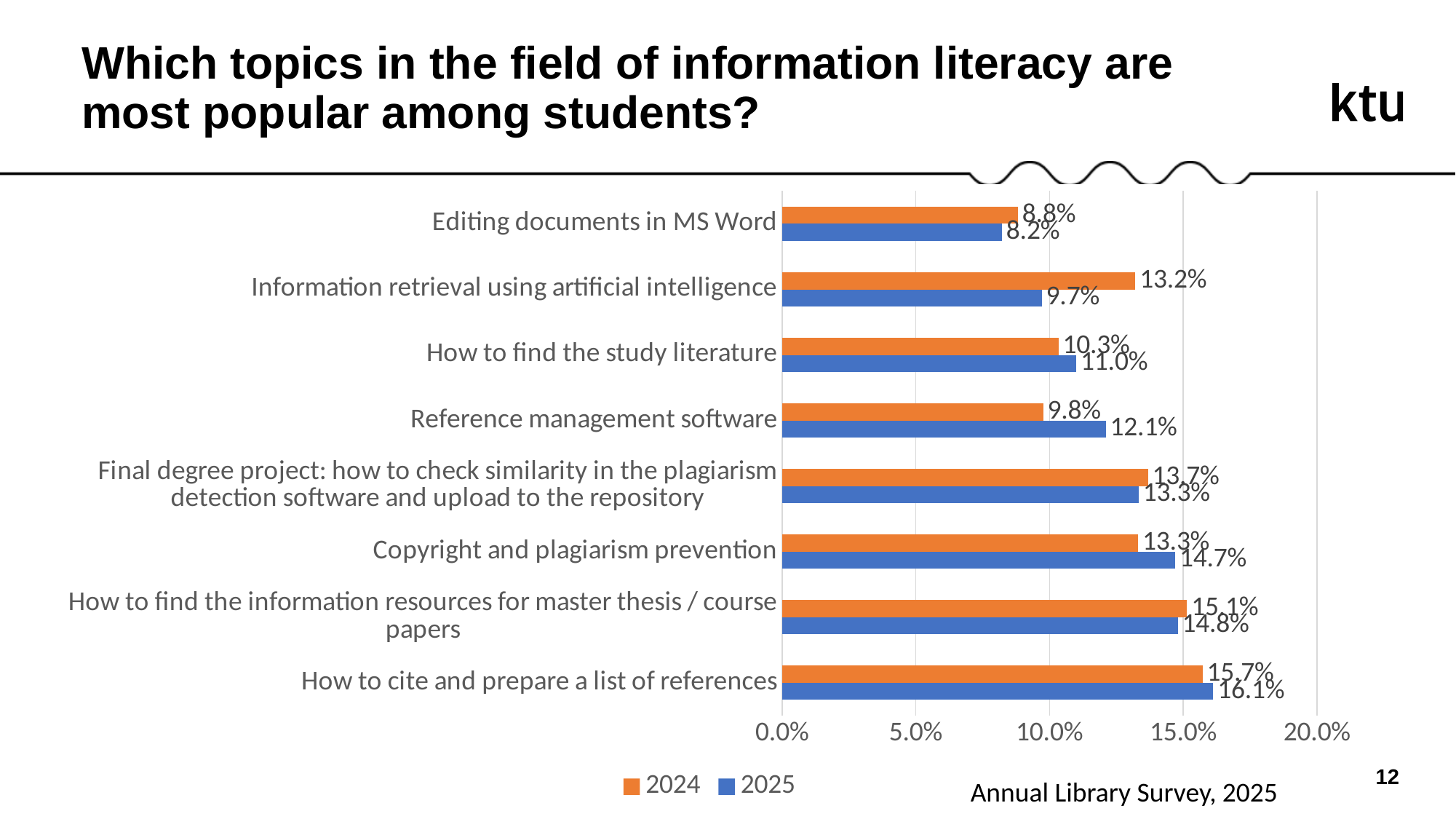
What is the 2025 value for Copyright and plagiarism prevention? 14.7% Which is larger for Reference management software, the 2024 value or the 2025 value? 2025 How many series does the legend list? 2 Which topic has the highest 2025 value? How to cite and prepare a list of references What is the 2024 value for Reference management software? 9.8% How many topics (categories) are shown in the chart? 8 What is the difference between the 2024 and 2025 values for Information retrieval using artificial intelligence? 3.5% Is the 2024 value for How to find the information resources for master thesis / course papers greater or less than 15.0%? greater Which topic has the lowest 2024 value? Editing documents in MS Word Which colour represents the 2024 series in the chart? orange What is the 2025 value for Information retrieval using artificial intelligence? 9.7% What kind of chart is shown on the slide? bar chart